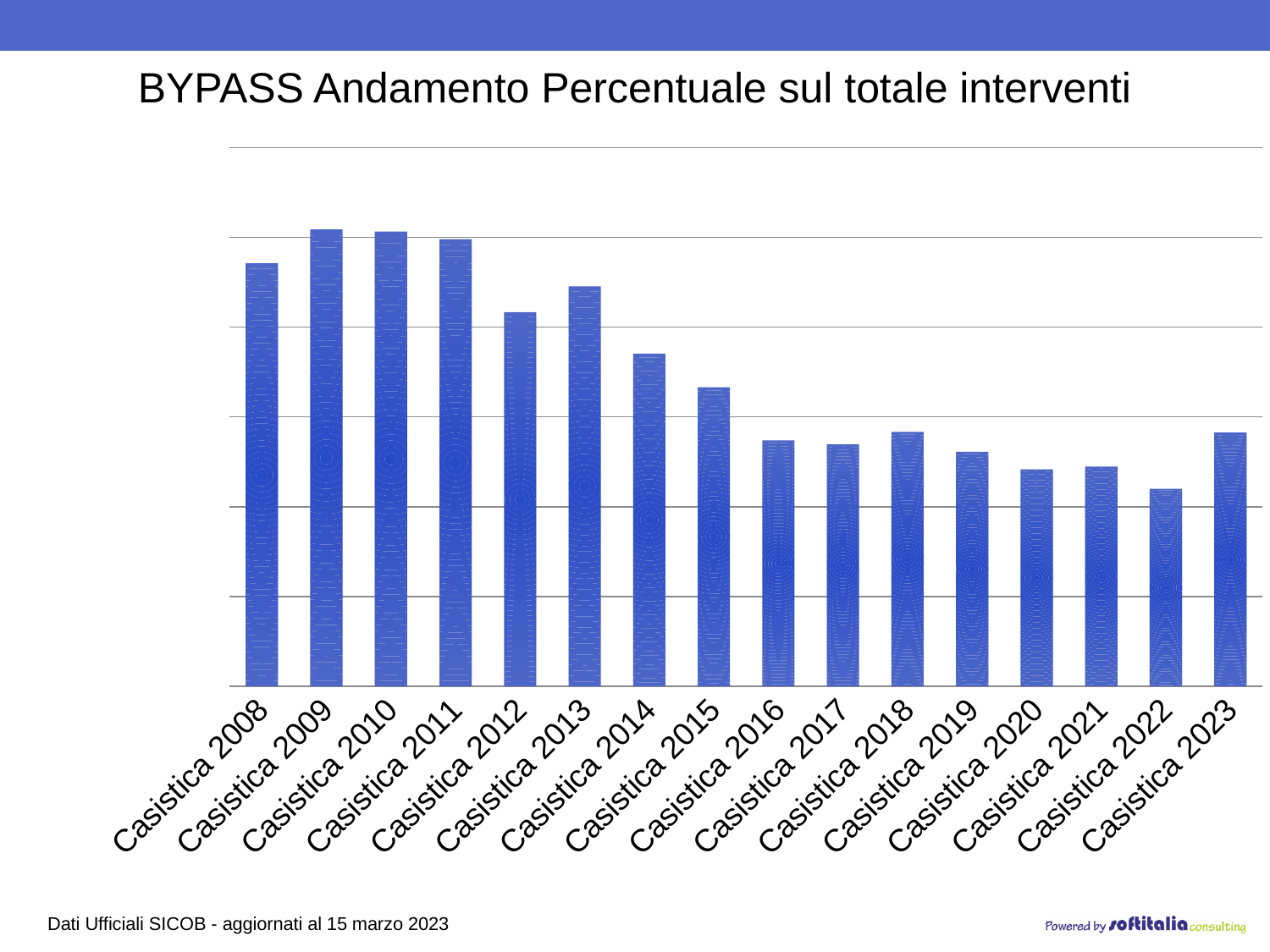
Do the values rise or fall from Casistica 2011 to Casistica 2017? fall Which is larger, the value for Casistica 2023 or the value for Casistica 2022? Casistica 2023 How many categories (bars) are plotted in the chart? 16 What kind of chart is shown on the slide? bar chart Which category has the lowest bar in the chart? Casistica 2022 Which is larger, the value for Casistica 2008 or the value for Casistica 2016? Casistica 2008 What is the title of the chart? BYPASS Andamento Percentuale sul totale interventi Which is larger, the value for Casistica 2014 or the value for Casistica 2015? Casistica 2014 Do the values rise or fall from Casistica 2022 to Casistica 2023? rise What is the label of the first category on the x axis? Casistica 2008